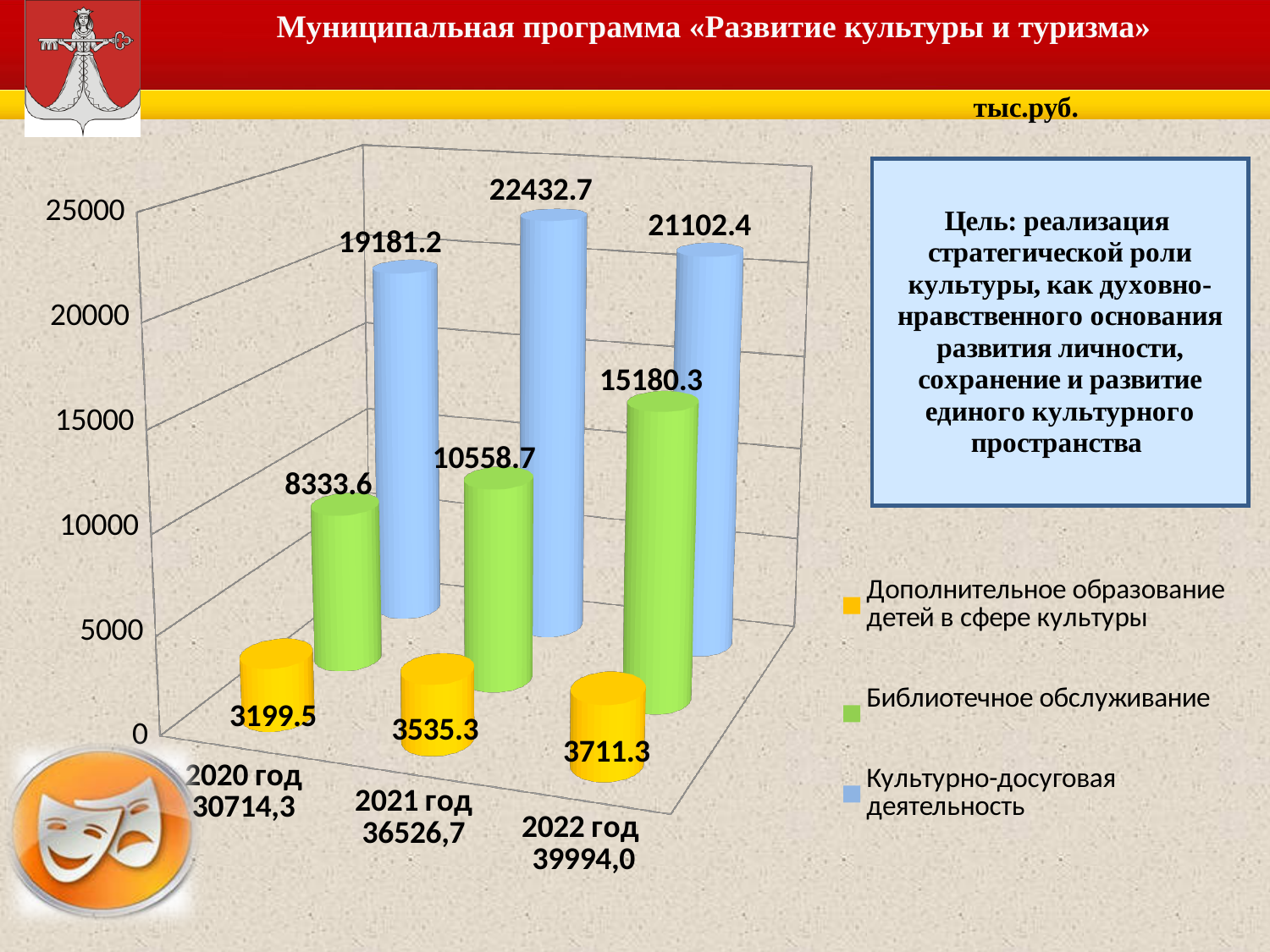
Which colour represents Библиотечное обслуживание in the legend? green In which year is the value for Культурно-досуговая деятельность highest? 2021 год In which year is the value for Библиотечное обслуживание lowest? 2020 год How many years are shown on the x axis? 3 What is the value for Дополнительное образование детей в сфере культуры in 2022 год? 3711.3 Which is larger: Культурно-досуговая деятельность in 2022 год or in 2020 год? 2022 год What is the value for Библиотечное обслуживание in 2021 год? 10558.7 What is the value for Культурно-досуговая деятельность in 2020 год? 19181.2 How many series does the legend list? 3 What kind of chart is shown on the slide? bar chart What is the difference between the Библиотечное обслуживание values for 2022 год and 2021 год? 4621.6 Do the values for Дополнительное образование детей в сфере культуры rise or fall from 2020 год to 2022 год? rise